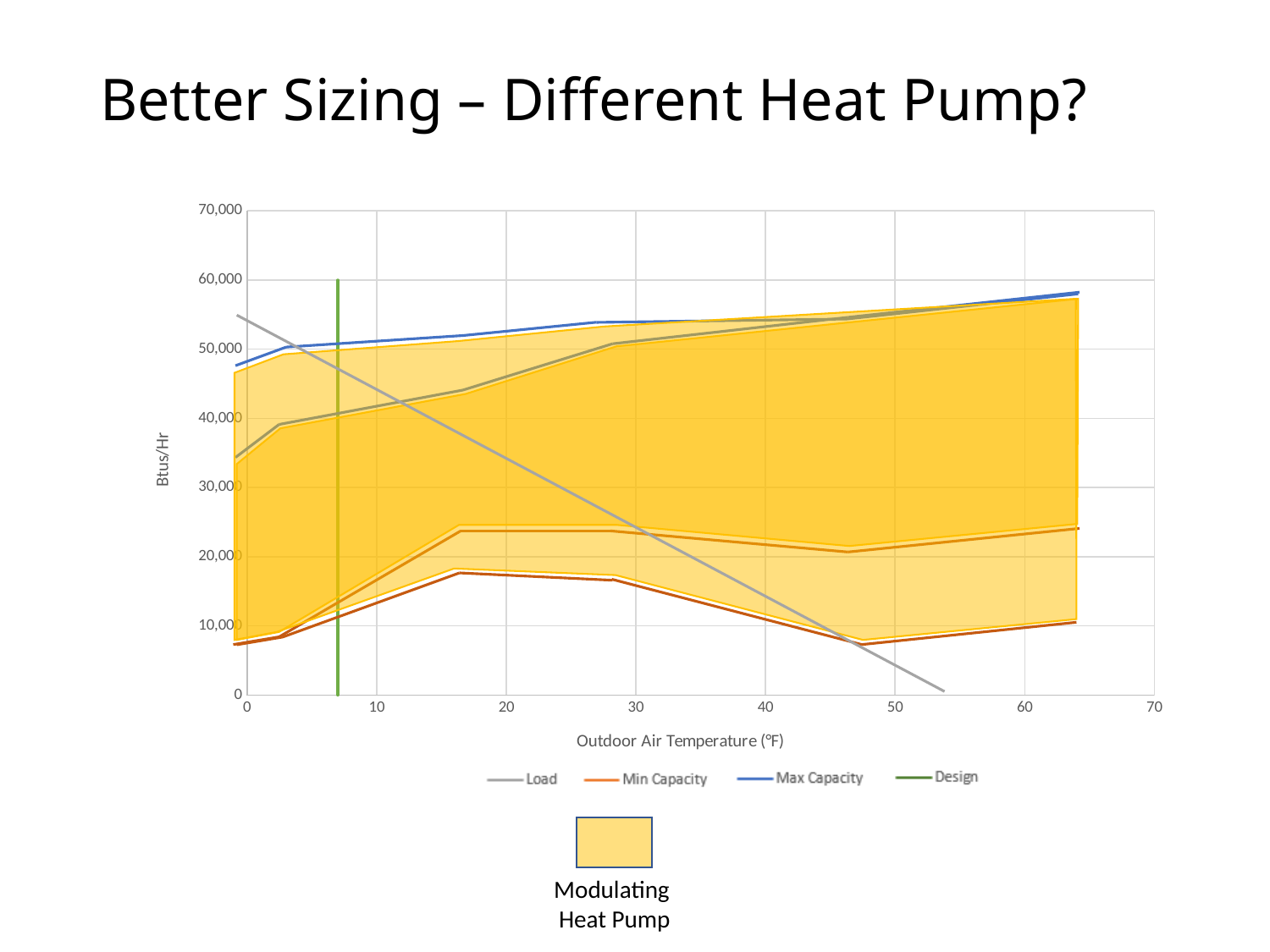
Is the Min Capacity value at 64°F greater or less than 30,000 Btus/Hr? less Is the Load value at 50°F greater or less than 10,000 Btus/Hr? less Is the Load value at 0°F greater or less than 50,000 Btus/Hr? greater What are the series names listed in the chart legend? Load, Min Capacity, Max Capacity, Design What is the title of the vertical axis of the chart? Btus/Hr At 0°F, which is larger: the Load value or the Max Capacity value? Load At 64°F, which is larger: the Max Capacity value or the Min Capacity value? Max Capacity What kind of chart is shown on the slide? line chart Does the Load series rise or fall as outdoor air temperature increases? fall Does the Max Capacity series rise or fall as outdoor air temperature increases? rise How many series does the chart legend list? 4